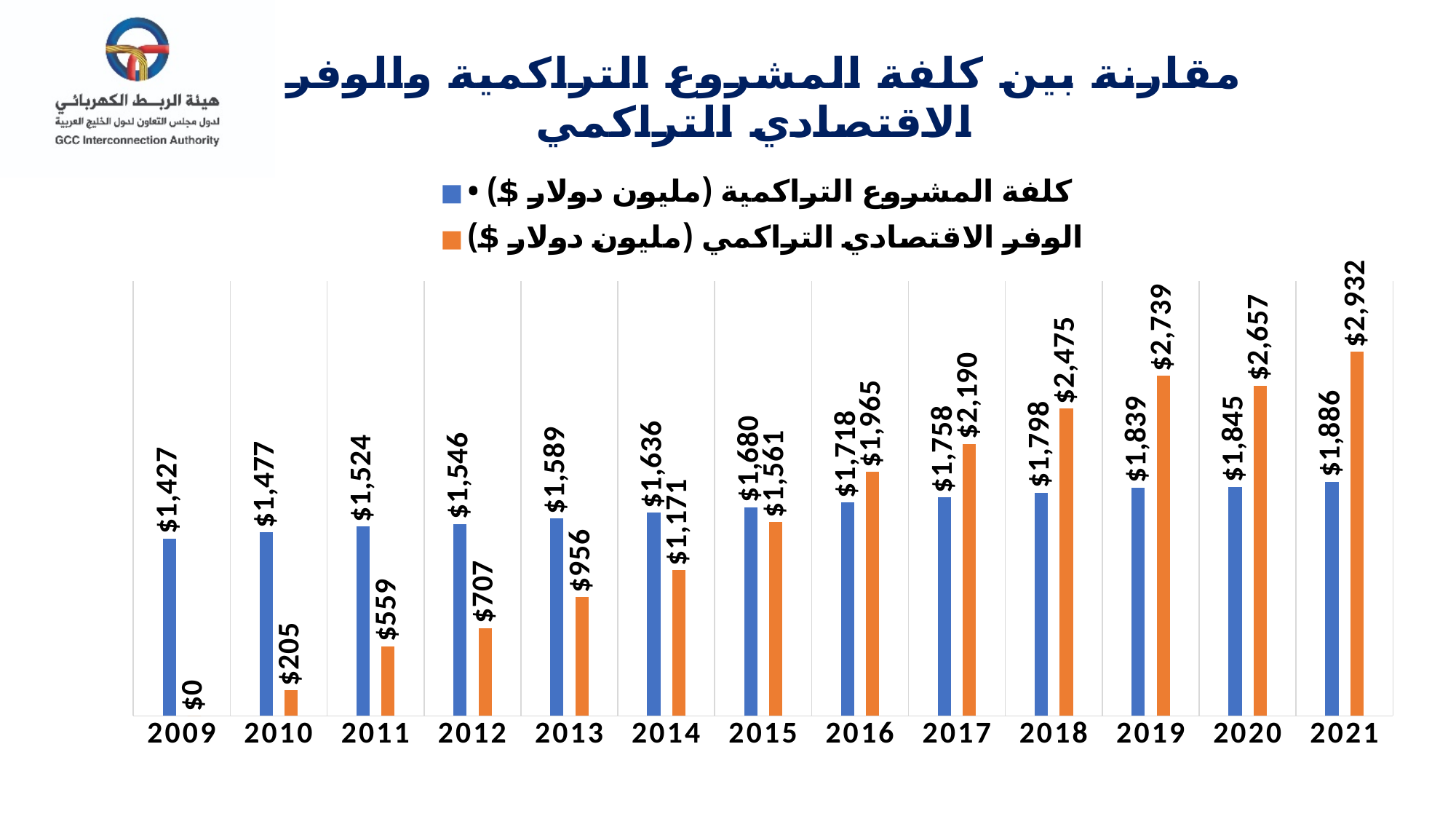
What is the cumulative project cost (كلفة المشروع التراكمية, blue bar) for 2009? $1,427 In 2014, which is larger: the cumulative project cost (blue) or the cumulative economic saving (orange)? Cumulative project cost (blue) What kind of chart is shown on the slide? Bar chart In 2018, which is larger: the cumulative project cost (blue) or the cumulative economic saving (orange)? Cumulative economic saving (orange) How many series does the chart legend list? 2 How many years are shown on the x axis of the chart? 13 What is the difference between the cumulative economic saving and the cumulative project cost in 2021? $1,046 What is the cumulative economic saving (orange bar) for 2010? $205 In which year is the cumulative economic saving (orange bar) lowest? 2009 In which year is the cumulative economic saving (orange bar) highest? 2021 Does the cumulative project cost (blue bars) rise or fall from 2009 to 2021? Rise What is the cumulative economic saving (الوفر الاقتصادي التراكمي, orange bar) for 2016? $1,965